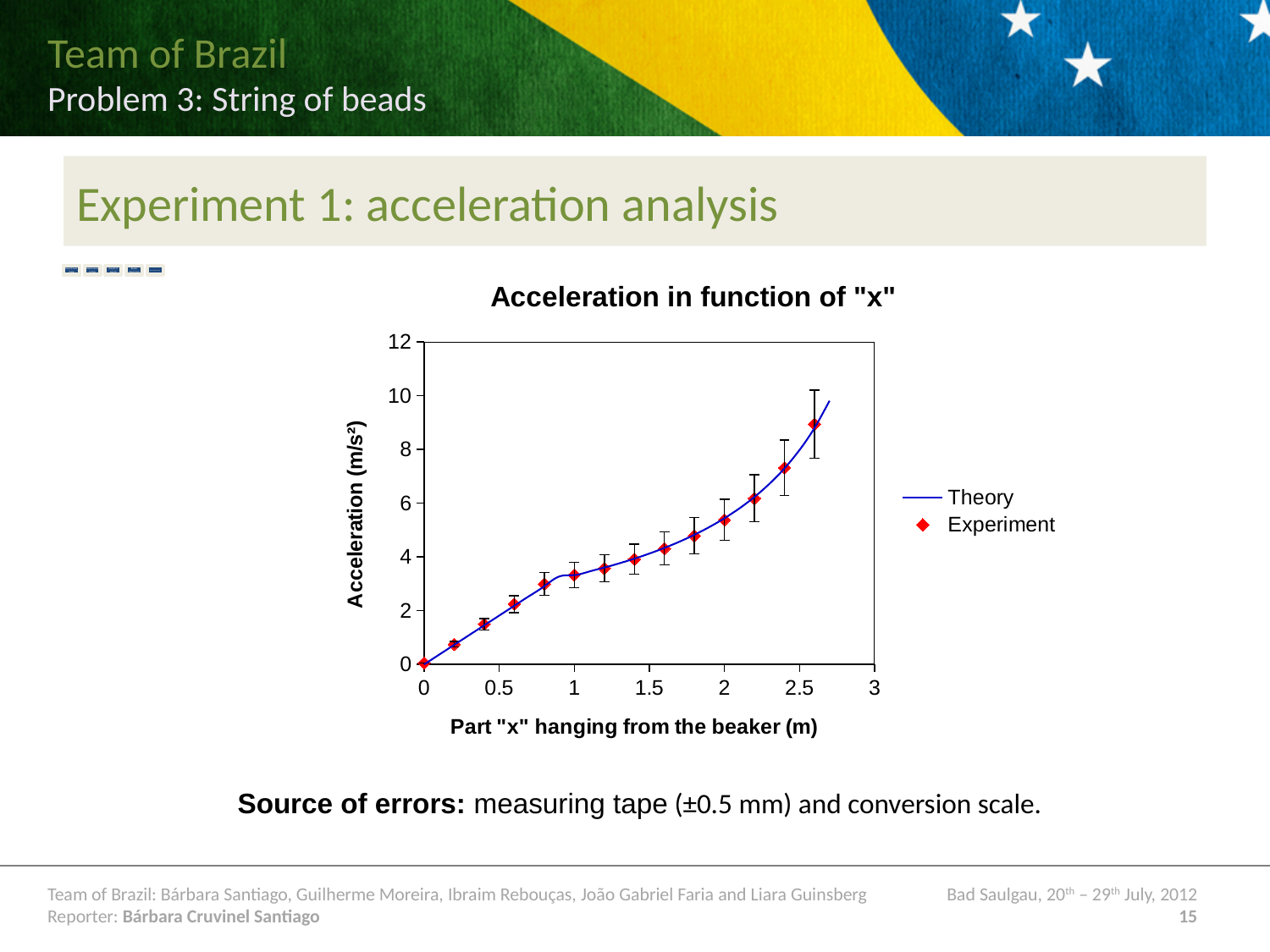
Is the Experiment acceleration at x = 2 m greater or less than 4? greater Does the acceleration rise or fall as "x" increases along the x axis? Rises Is the Experiment acceleration at x = 2.6 m greater or less than 8? greater Which Experiment point has the highest acceleration, x = 2.6 m or x = 0.2 m? x = 2.6 m What kind of chart is shown on the slide? Scatter chart with a line Is the Experiment acceleration at x = 1 m greater or less than 4? less At which value of x is the Experiment acceleration lowest? 0 What are the two series named in the legend? Theory and Experiment How many Experiment data points are plotted? 14 What is the label of the y axis? Acceleration (m/s²) How many series does the chart legend list? 2 What is the title of the chart? Acceleration in function of "x"